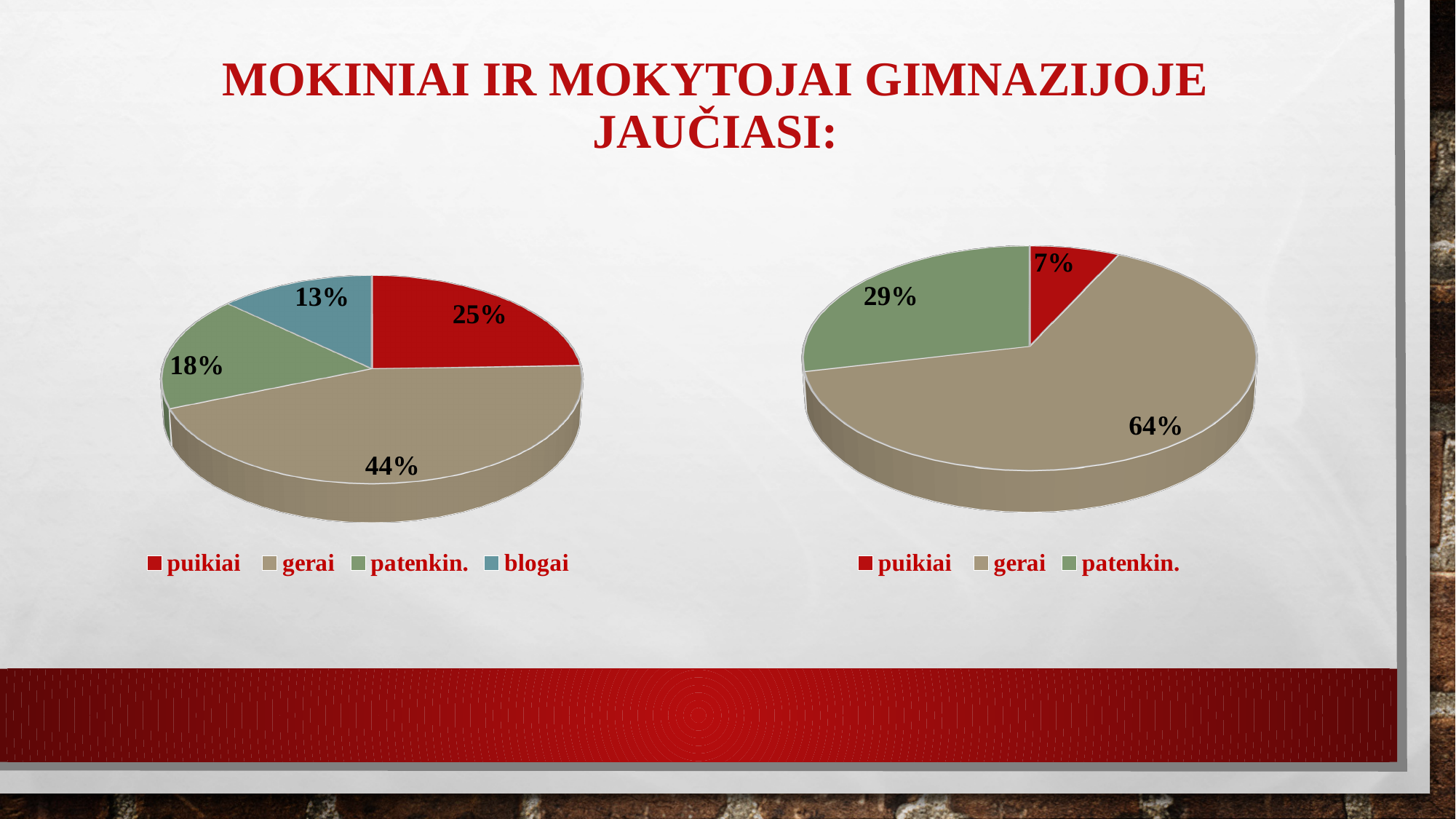
In the right pie chart, what percentage is shown for the 'puikiai' slice? 7% In the left pie chart, what is the difference in percentage points between 'gerai' and 'puikiai'? 19 In the left pie chart, what percentage is shown for the 'blogai' slice? 13% In the left pie chart, which category has the smallest slice? blogai In the left pie chart, what percentage is shown for the 'gerai' slice? 44% In the right pie chart, which category has the smallest slice? puikiai How many categories does the legend of the right pie chart list? 3 In the left pie chart, which category has the largest slice? gerai In the right pie chart, what is the difference in percentage points between 'gerai' and 'patenkin.'? 35 In the right pie chart, what percentage is shown for the 'patenkin.' slice? 29% What type of chart is shown on the left side of the slide? Pie chart In the left pie chart, which is larger, the 'patenkin.' slice or the 'puikiai' slice? puikiai